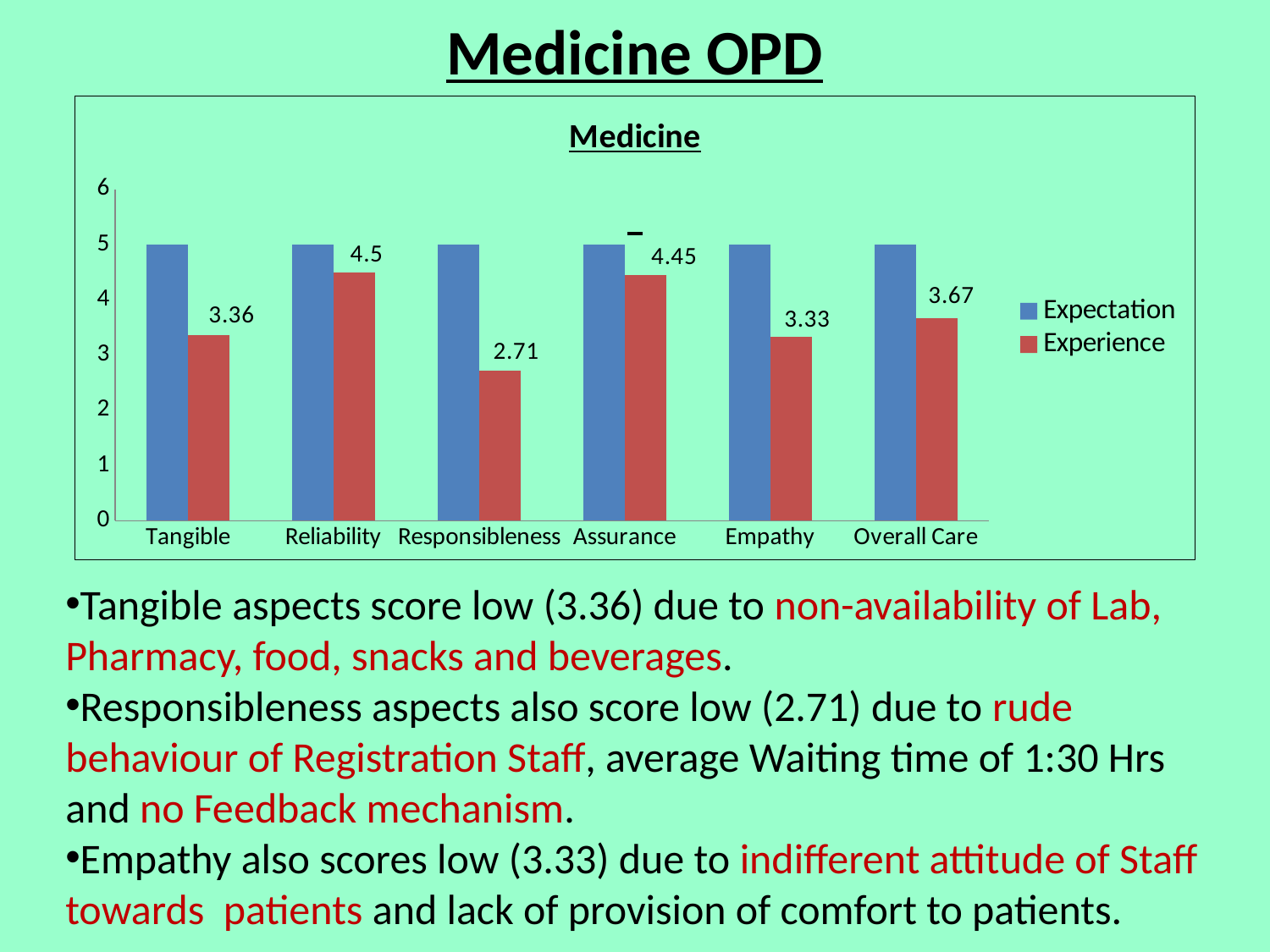
Is the Expectation value for Assurance greater or less than 4? greater How many categories are shown on the x axis? 6 Which has a larger Experience value, Tangible or Empathy? Tangible How many series does the legend list? 2 Which category has the lowest Experience value? Responsibleness Which category has the highest Experience value? Reliability What are the two series named in the legend? Expectation and Experience What is the Experience value for Overall Care? 3.67 What is the Experience value for Responsibleness? 2.71 What is the difference between the Experience values for Reliability and Responsibleness? 1.79 What is the Experience value for Tangible? 3.36 What kind of chart is shown? bar chart